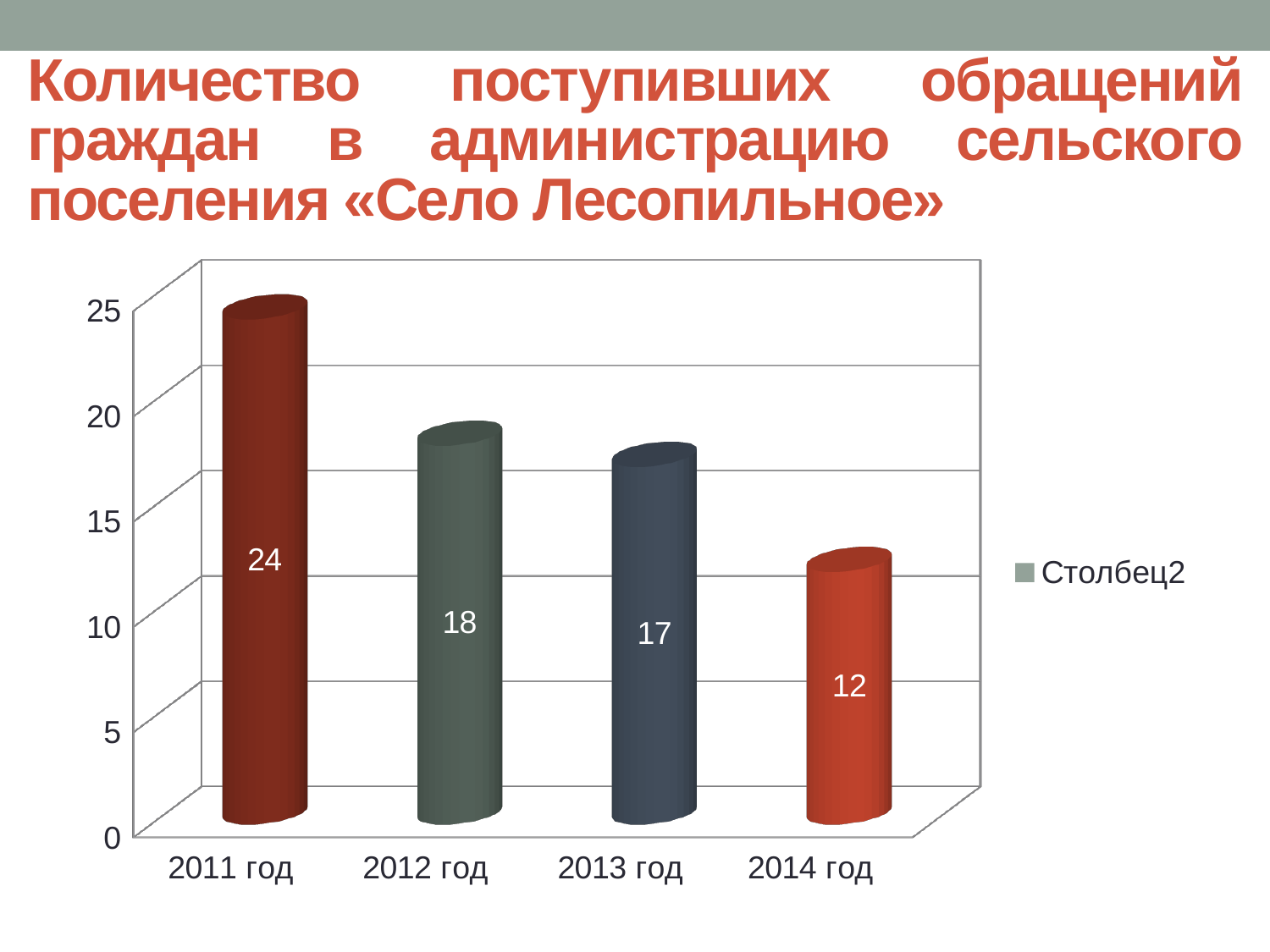
Do the values rise or fall from 2011 год to 2014 год? fall How many years are shown on the x axis? 4 What is the value for 2014 год? 12 Which year has the highest value? 2011 год What kind of chart is shown on the slide? bar chart How many series does the legend list? 1 What is the difference between the values for 2011 год and 2014 год? 12 What is the value for 2013 год? 17 Which is larger, the value for 2012 год or the value for 2014 год? 2012 год What is the difference between the values for 2012 год and 2013 год? 1 Which year has the lowest value? 2014 год What is the value for 2011 год? 24